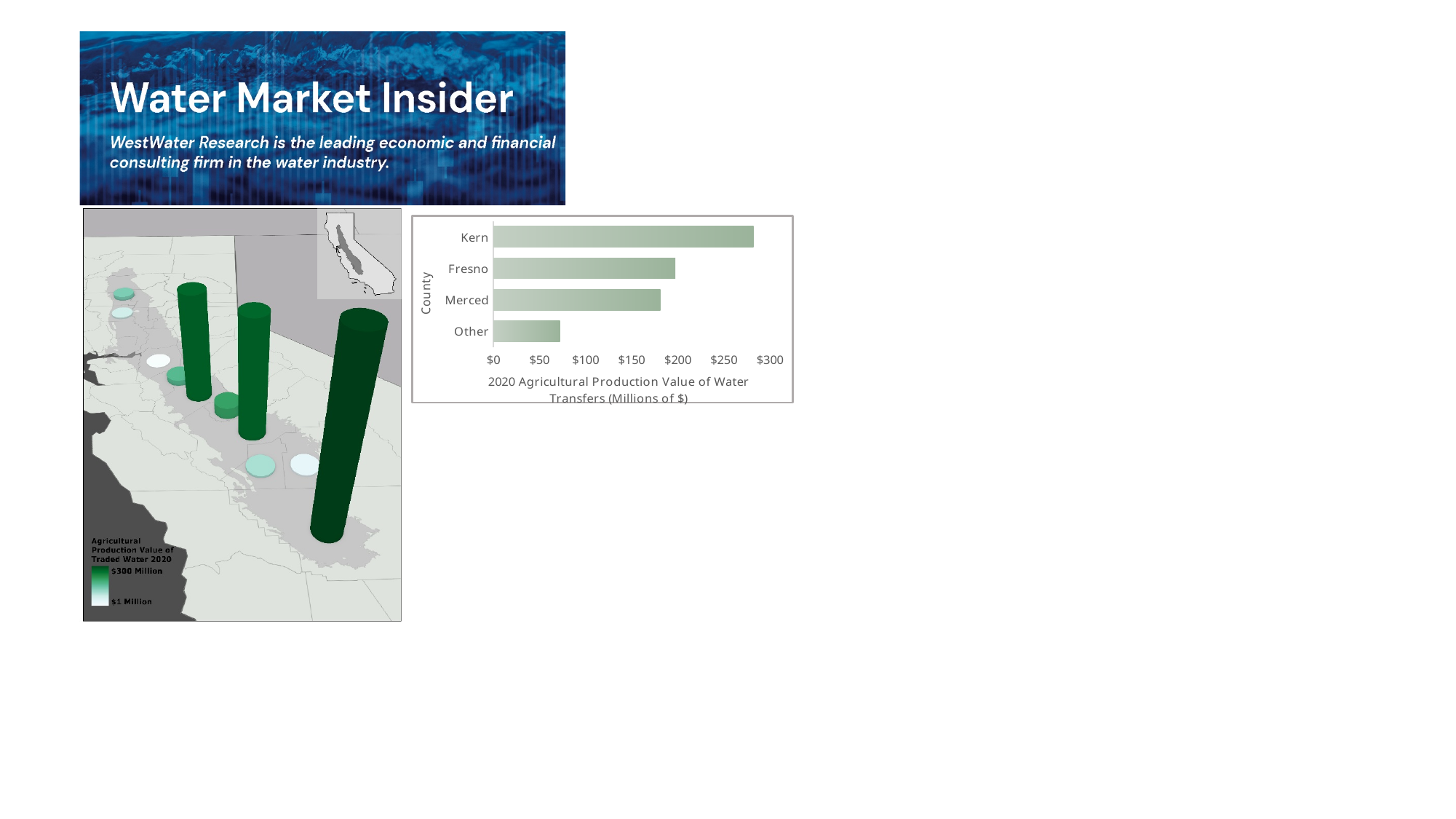
In the bar chart, is the value for Fresno greater or less than $150? greater What is the title of the x axis of the bar chart? 2020 Agricultural Production Value of Water Transfers (Millions of $) In the bar chart, how many counties are listed on the y axis? 4 In the bar chart, which has a larger value, Merced or Other? Merced In the bar chart, which has a larger value, Kern or Fresno? Kern What is the title of the y axis of the bar chart? County In the bar chart, is the value for Kern greater or less than $250? greater In the bar chart, is the value for Other greater or less than $100? less In the bar chart, which category has the lowest value? Other What kind of chart is shown on the right of the slide? bar chart In the bar chart, which county has the highest 2020 agricultural production value of water transfers? Kern